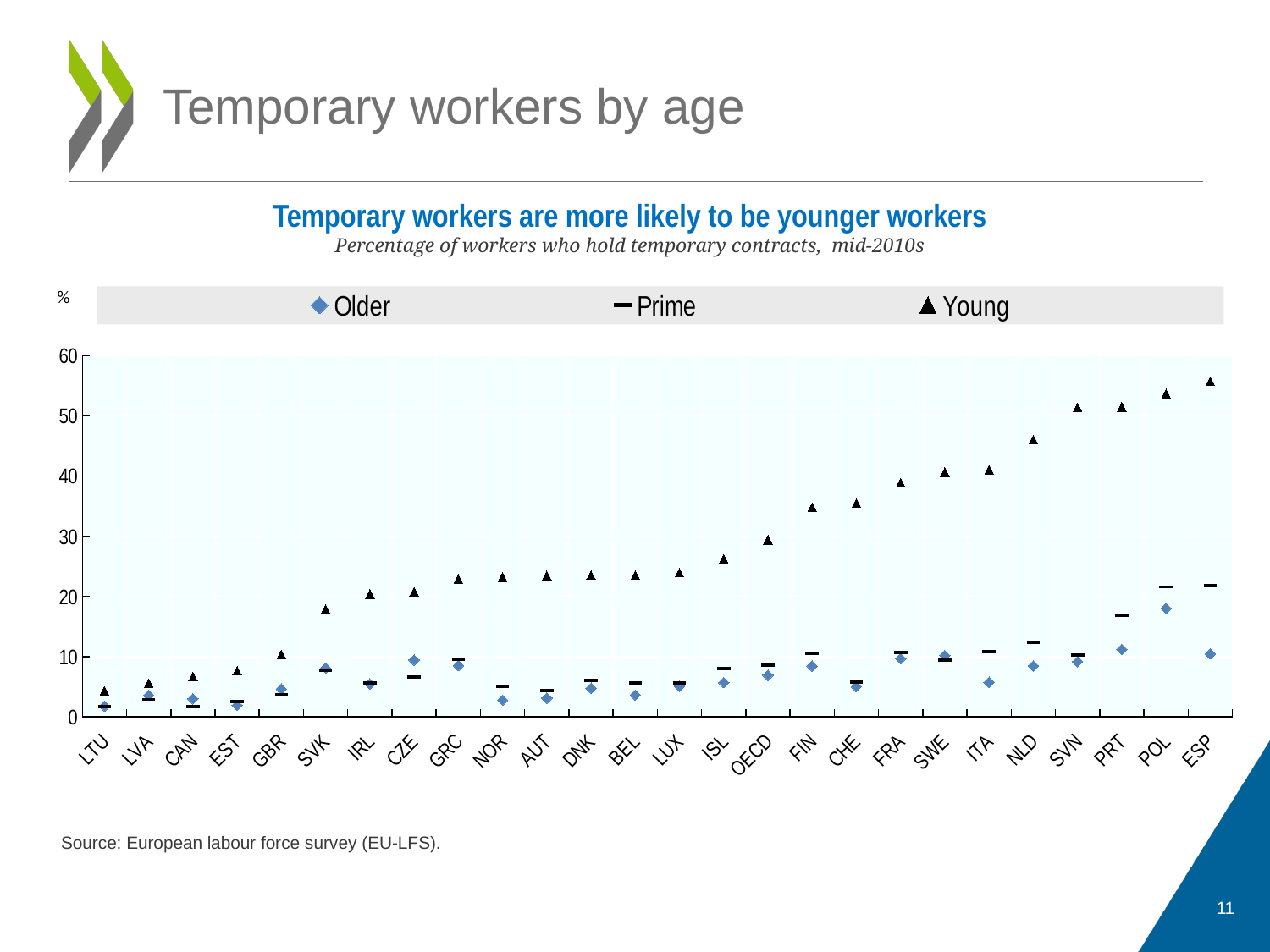
Is the Young value for ESP greater or less than 50? greater How many countries/categories are shown on the x axis? 26 How many series does the legend list? 3 Which series are shown in the legend? Older, Prime, Young Which category has the lowest value for the Young series? LTU Is the Young value for NLD greater or less than 40? greater Is the Prime value for PRT greater or less than 10? greater Which category has the highest value for the Young series? ESP For ESP, which is larger: the Young value or the Older value? Young Which category has the highest value for the Older series? POL Do the Young series values generally rise or fall from left to right along the x axis? rise